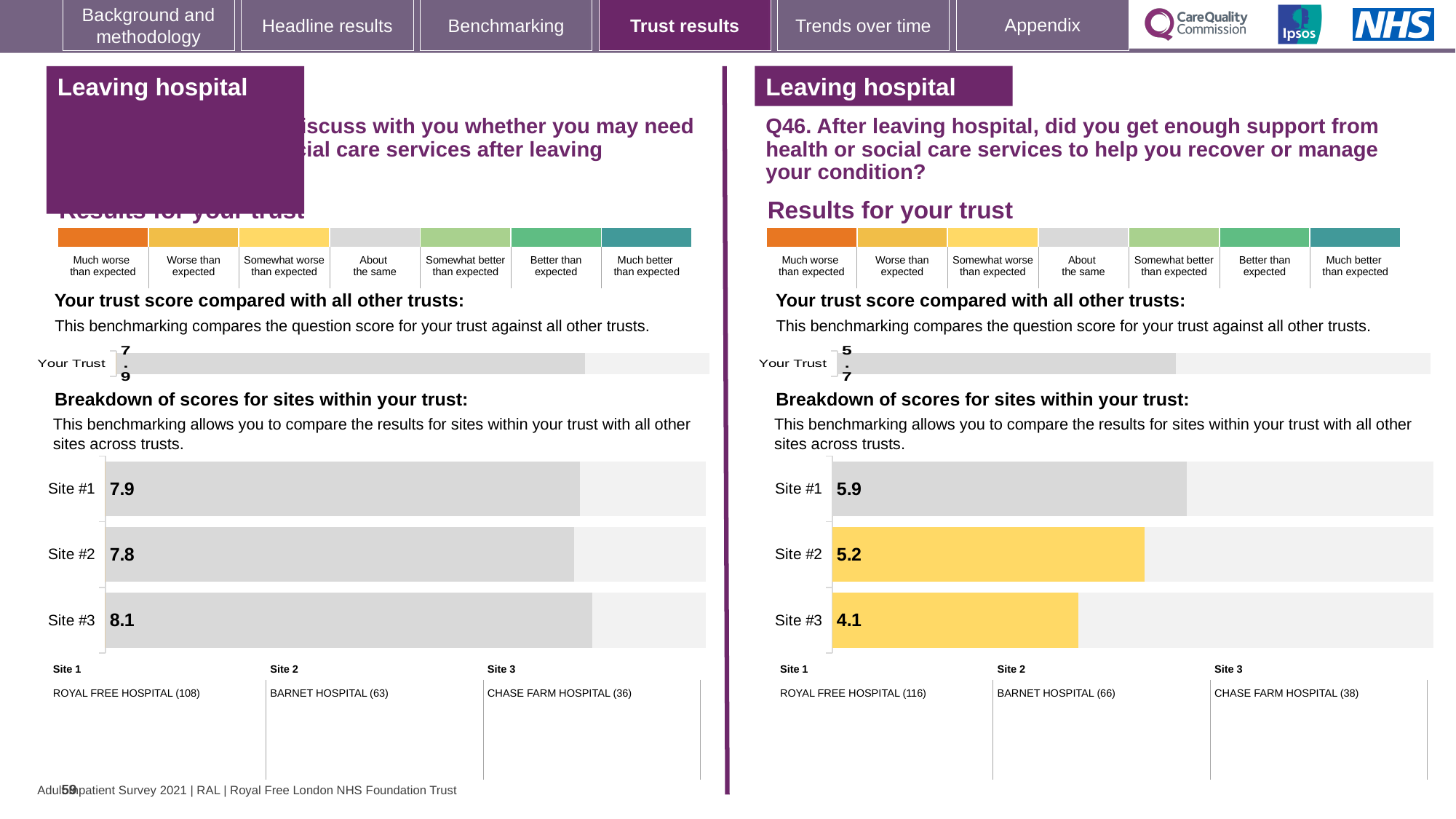
On the right-hand (Q46) site breakdown chart, do the scores rise or fall from Site #1 to Site #3? Fall What type of chart is used for the site breakdown on the right-hand (Q46) side? Bar chart On the right-hand (Q46) site breakdown chart, what is the score for Site #3? 4.1 On the right-hand (Q46) 'Your Trust' chart, what is the trust score? 5.7 On the left-hand site breakdown chart, what is the score for Site #2? 7.8 How many sites are shown on the left-hand site breakdown chart? 3 On the right-hand (Q46) site breakdown chart, which site has the lowest score? Site #3 On the left-hand site breakdown chart, what is the difference between the scores for Site #3 and Site #2? 0.3 On the right-hand (Q46) site breakdown chart, what is the score for Site #1? 5.9 On the right-hand (Q46) site breakdown chart, what is the difference between the scores for Site #1 and Site #3? 1.8 On the right-hand (Q46) site breakdown chart, which is larger, the score for Site #2 or Site #3? Site #2 On the left-hand site breakdown chart, which site has the highest score? Site #3